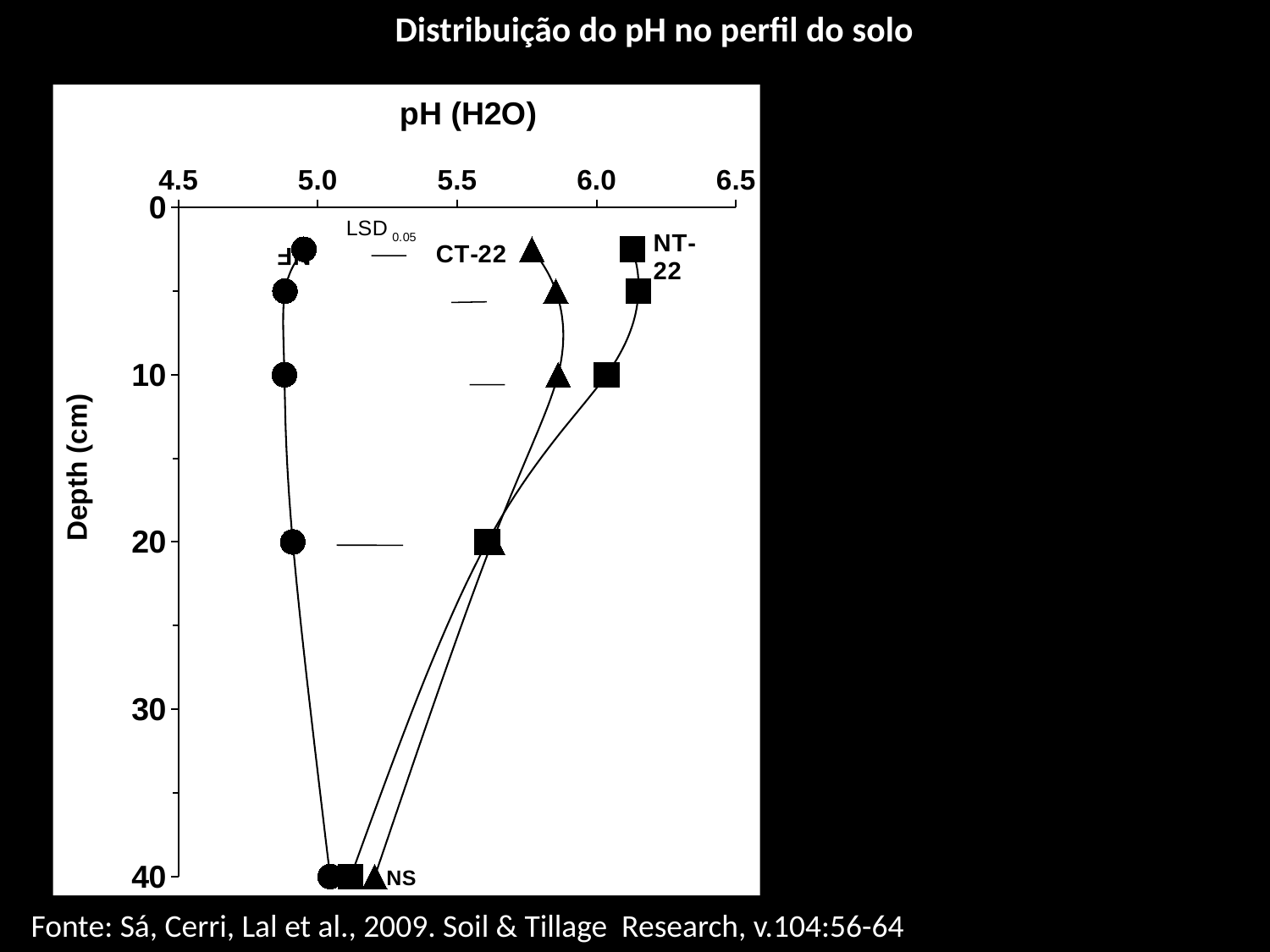
What is the label of the horizontal axis of the chart? pH (H2O) At a depth of 10 cm, which series has the higher pH, NT-22 or CT-22? NT-22 Does the pH of the NT-22 series rise or fall as depth increases from 5 cm to 40 cm? fall How many depth points are plotted for the NT-22 series? 5 What is the title of the chart on the slide? Distribuição do pH no perfil do solo What kind of chart is shown on the slide? line chart At a depth of 5 cm, which series has the highest pH? NT-22 Is the pH value for NT-22 at a depth of 10 cm greater or less than 5.5? greater Is the pH value for the series plotted with circle markers at a depth of 10 cm greater or less than 5.0? less Is the pH value for CT-22 at a depth of 40 cm greater or less than 5.0? greater At a depth of 20 cm, which series has the lowest pH? the series with circle markers